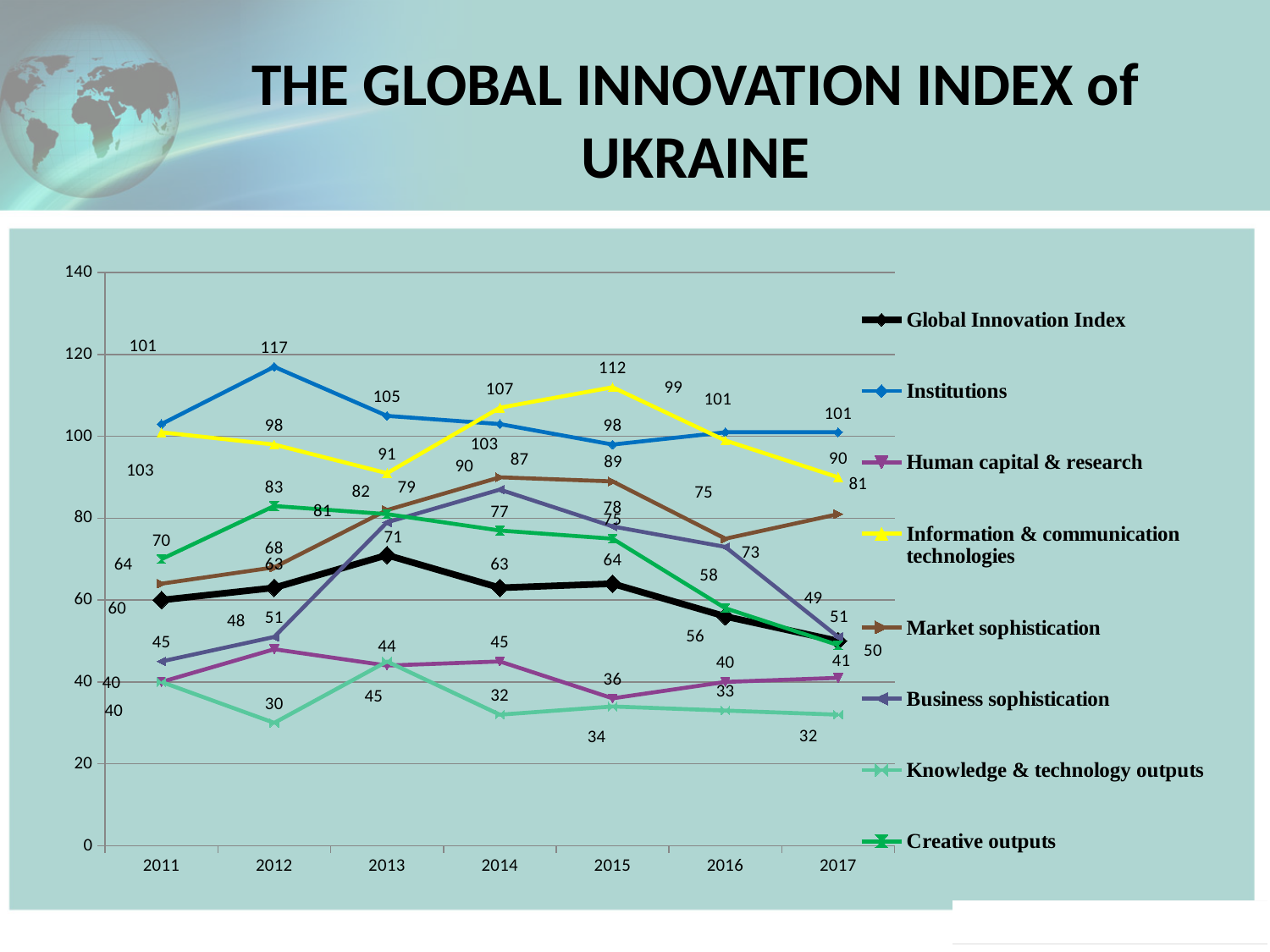
What is the value of the Global Innovation Index in 2013? 71 In which year is the Institutions series at its highest? 2012 Is the value for Creative outputs in 2012 greater or less than 80? greater In which year is Knowledge & technology outputs at its lowest? 2012 What is the difference between the Global Innovation Index in 2013 and in 2017? 21 What is the value of Institutions in 2012? 117 How many series does the legend list? 8 How many years are shown on the x axis? 7 What kind of chart is shown on the slide? line chart Does the Global Innovation Index rise or fall from 2015 to 2017? fall What is the value of Information & communication technologies in 2015? 112 In 2017, which is larger: Institutions or Information & communication technologies? Institutions